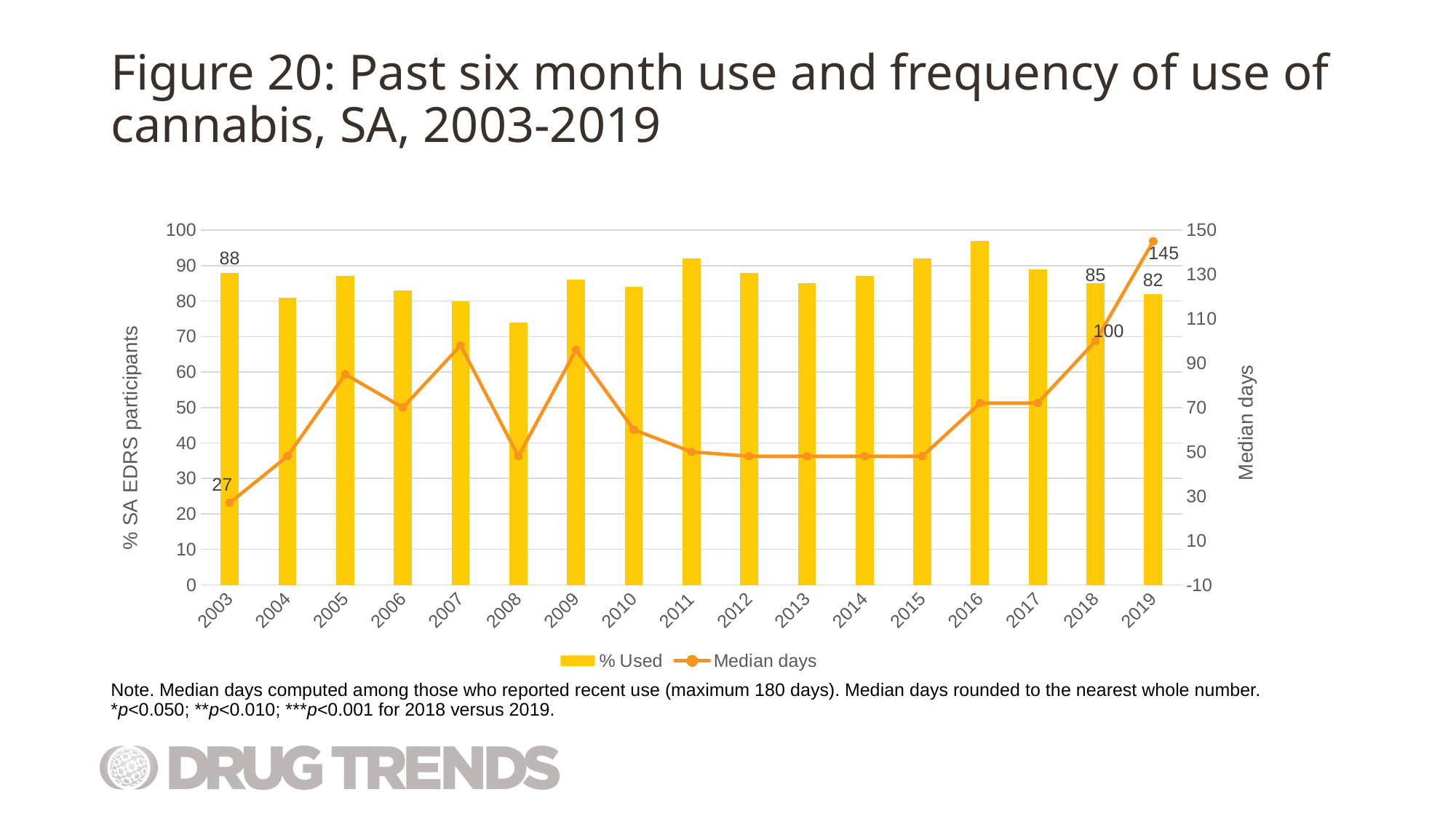
What is the Median days value for 2019? 145 What is the % Used value for 2018? 85 Which year has the highest Median days value? 2019 What is the Median days value for 2003? 27 Is the % Used value for 2008 greater or less than 80? less Which year has the highest % Used bar? 2016 Which year has the lowest % Used bar? 2008 How many series does the legend list? 2 What is the difference in Median days between 2019 and 2018? 45 Which is larger, the % Used value for 2003 or for 2019? 2003 What is the % Used value for 2003? 88 How many years are shown on the x axis? 17